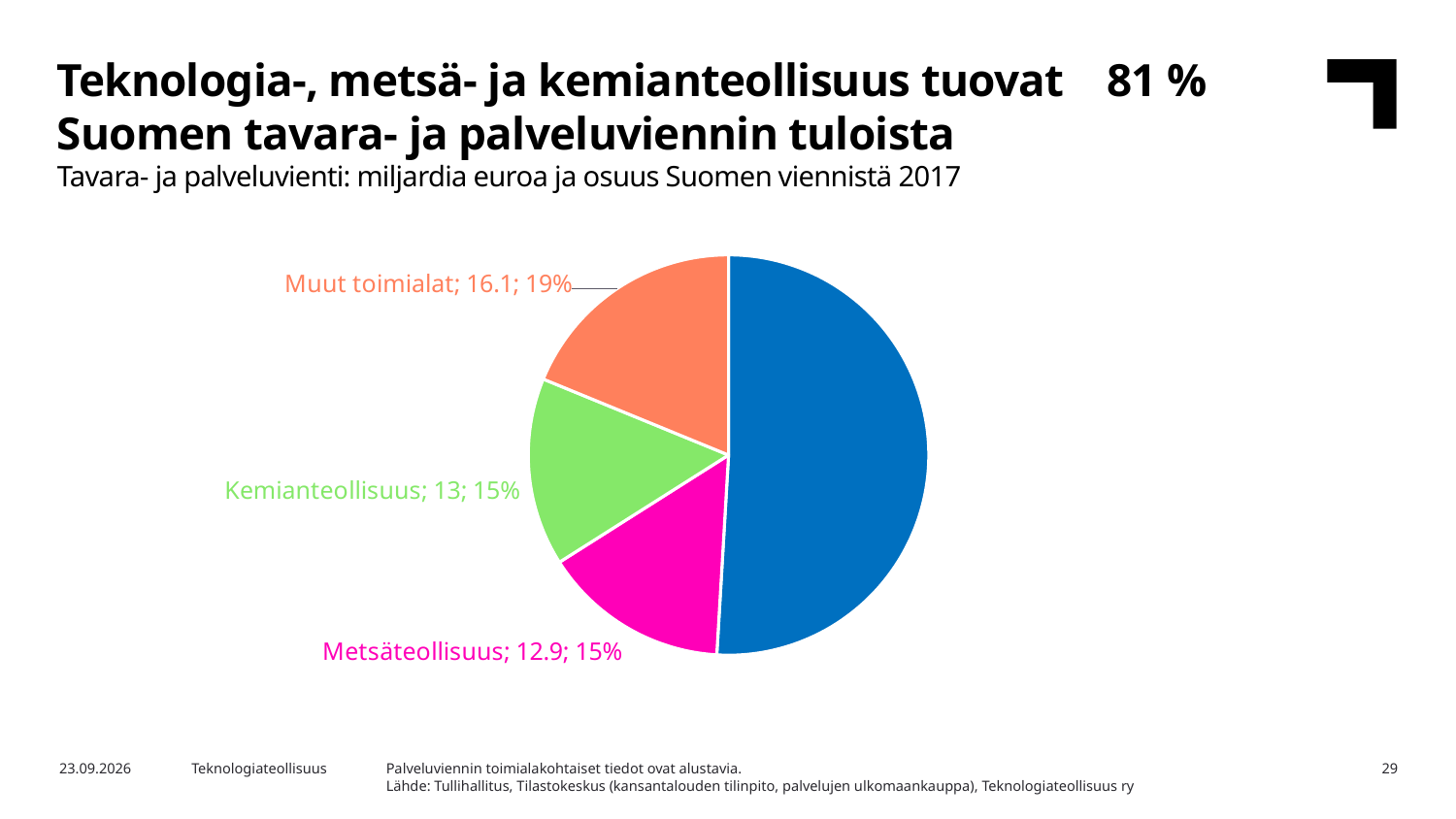
Which has the larger value, Kemianteollisuus or Metsäteollisuus? Kemianteollisuus What share of the pie does Muut toimialat represent? 19% What kind of chart is shown on the slide? pie chart How many slices does the pie chart have? 4 What is the value in billions of euros for Metsäteollisuus? 12.9 What is the value in billions of euros for Kemianteollisuus? 13 What share of the pie does Metsäteollisuus represent? 15% What is the difference between the values for Kemianteollisuus and Metsäteollisuus? 0.1 What is the subtitle of the chart on the slide? Tavara- ja palveluvienti: miljardia euroa ja osuus Suomen viennistä 2017 What is the difference between the values for Muut toimialat and Kemianteollisuus? 3.1 What is the value in billions of euros for Muut toimialat? 16.1 What colour is the Kemianteollisuus slice? green